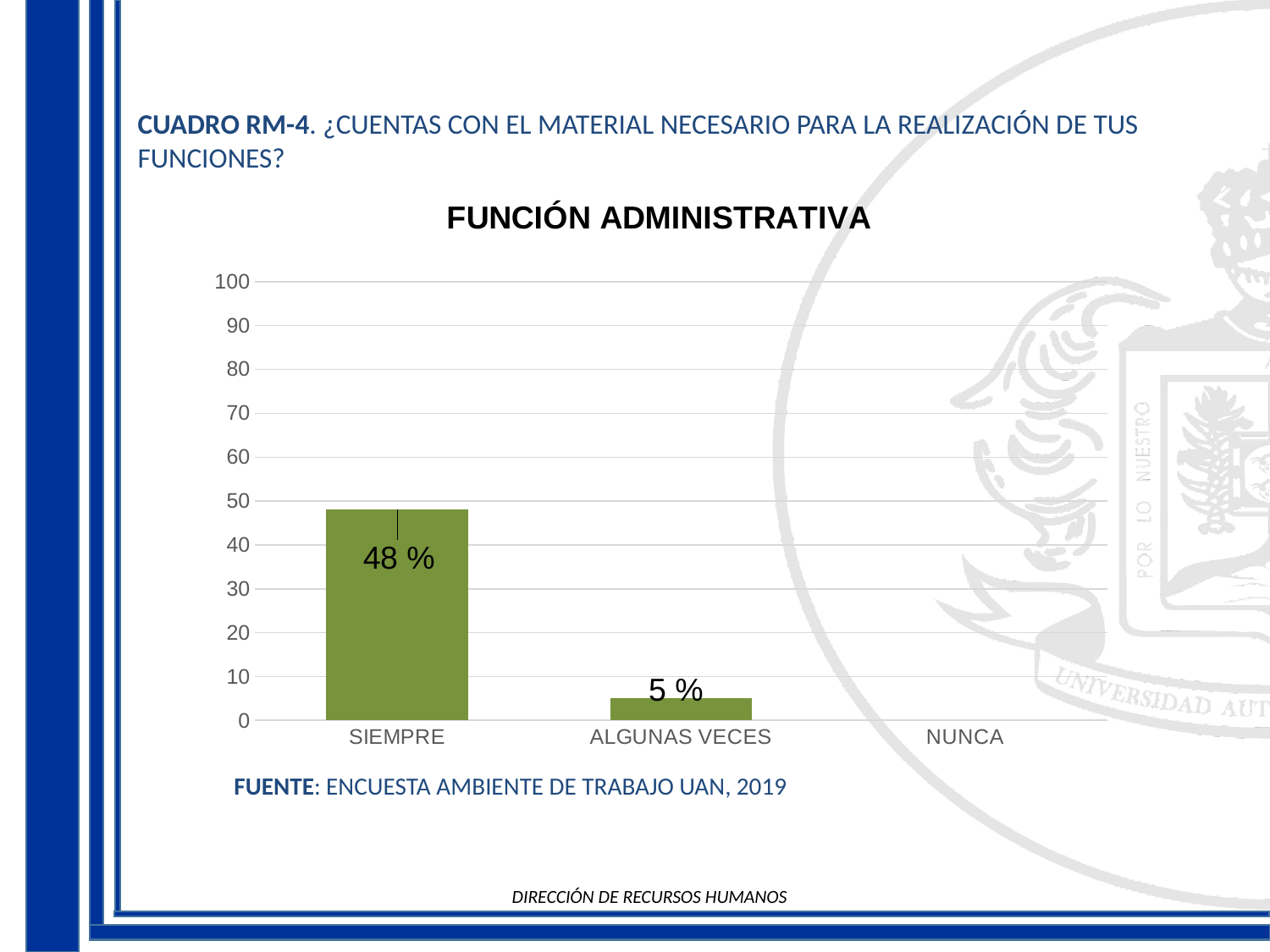
What is the highest value shown on the y axis? 100 Is the value for SIEMPRE greater or less than 50? less Which category has the highest value? SIEMPRE How many categories are shown on the x axis? 3 Which is larger, the value for SIEMPRE or the value for ALGUNAS VECES? SIEMPRE What is the value for ALGUNAS VECES? 5 % What is the value for SIEMPRE? 48 % What is the title of the chart? FUNCIÓN ADMINISTRATIVA What is the difference between the values for SIEMPRE and ALGUNAS VECES? 43 % Is the value for ALGUNAS VECES greater or less than 10? less What kind of chart is shown on the slide? bar chart Do the values rise or fall from left to right along the x axis? fall